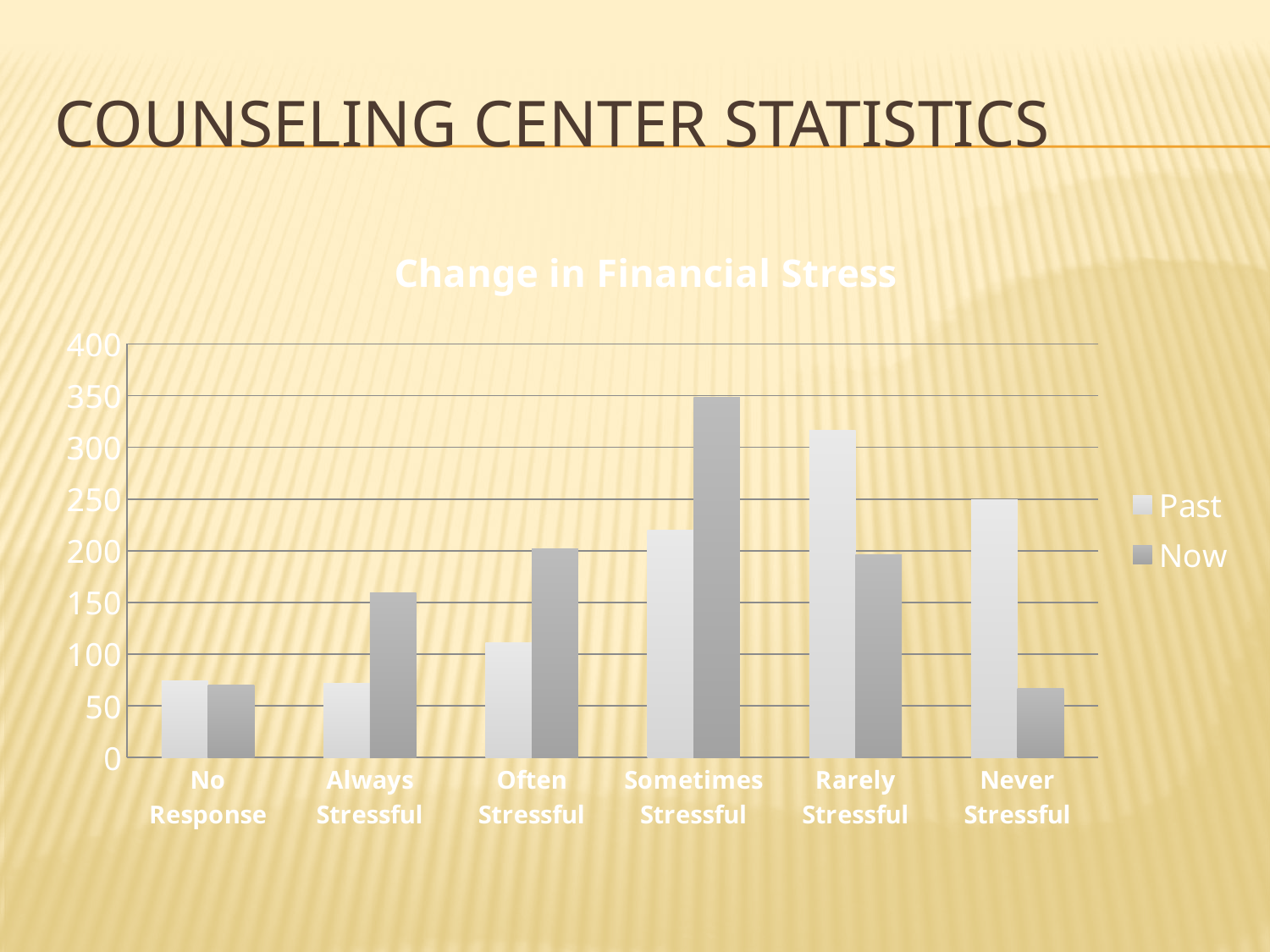
Is the Now value for Never Stressful greater or less than 100? less What are the two series named in the legend? Past and Now What kind of chart is shown on the slide? bar chart Which category has the highest value for the Past series? Rarely Stressful Is the Past value for Often Stressful greater or less than 150? less How many series does the legend list? 2 How many categories are shown on the x axis? 6 Is the Now value for Sometimes Stressful greater or less than 300? greater For Always Stressful, which is larger, the Past value or the Now value? Now Which category has the highest value for the Now series? Sometimes Stressful What is the title of the chart? Change in Financial Stress For Never Stressful, which is larger, the Past value or the Now value? Past